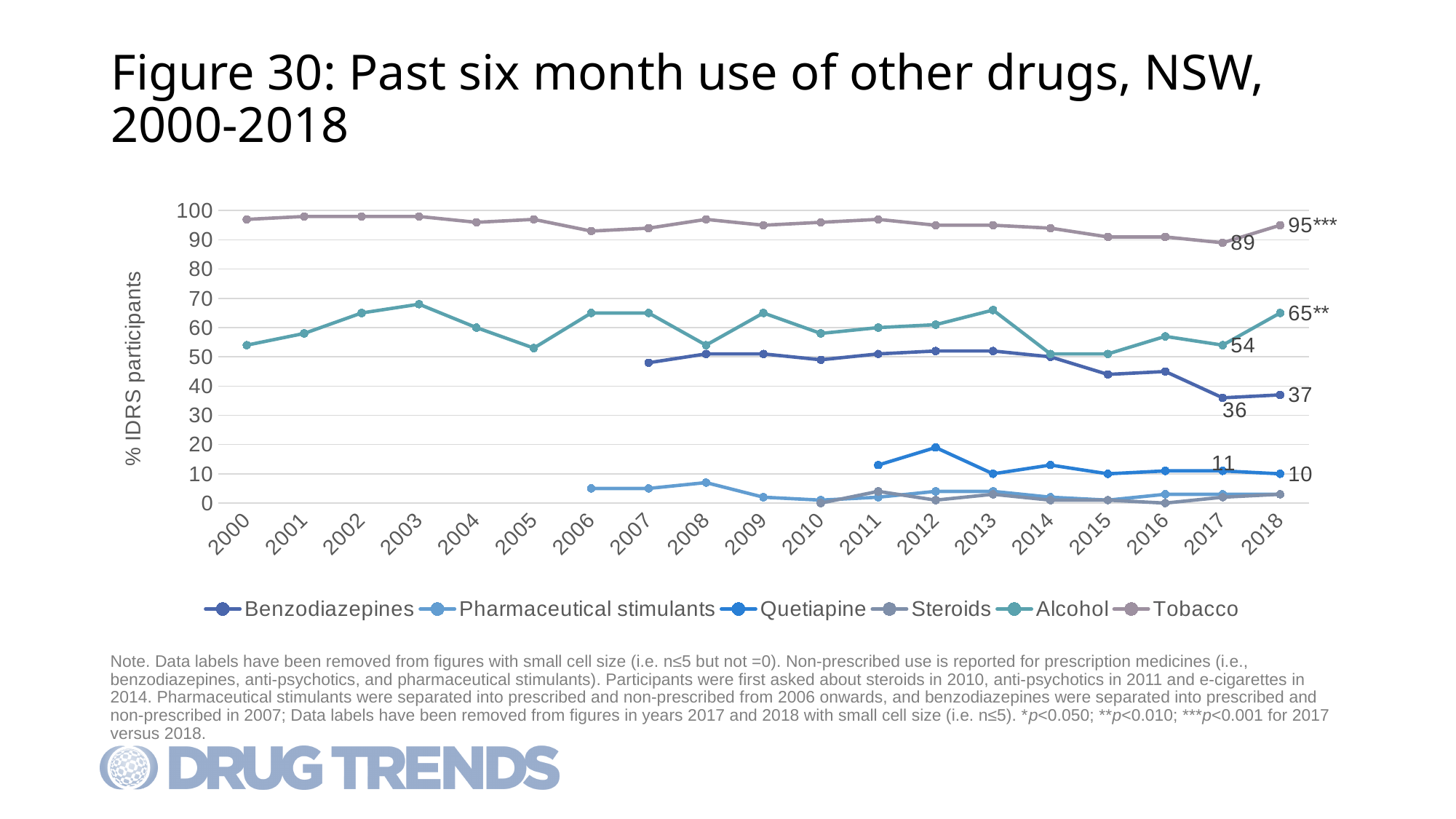
What is the value for Quetiapine in 2018? 10 What kind of chart is shown on the slide? line chart What is the difference between the Alcohol values in 2018 and 2017? 11 Is the value for Tobacco in 2000 greater or less than 90? greater Which series has the highest value in 2018? Tobacco Is the value for Quetiapine in 2012 greater or less than 10? greater What is the value for Tobacco in 2017? 89 What is the value for Benzodiazepines in 2017? 36 How many series does the legend list? 6 What is the value for Alcohol in 2018? 65** What is the difference between the Tobacco values in 2018 and 2017? 6 In 2018, which is larger: Alcohol or Benzodiazepines? Alcohol